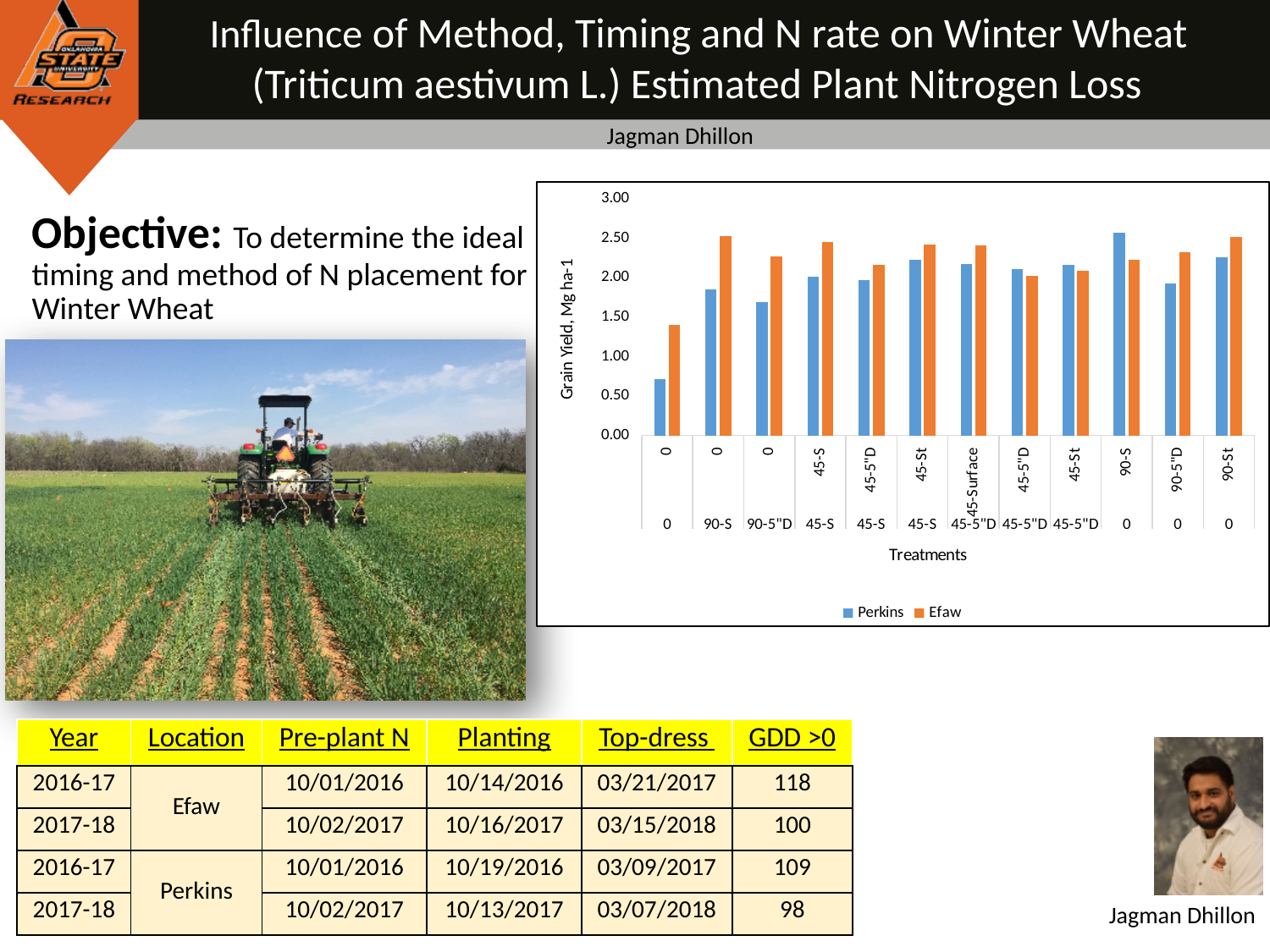
Is the Perkins value for the 90-5"D pre-plant treatment group greater or less than 2.00? less How many treatment groups are plotted along the x axis of the chart? 12 Is the Efaw value for the 90-S pre-plant treatment group greater or less than 2.00? greater What is the title of the vertical axis of the chart? Grain Yield, Mg ha-1 Which treatment group has the highest Perkins grain yield? 90-S top-dress (0 pre-plant) For the first treatment group (0 / 0), which series has the lower grain yield, Perkins or Efaw? Perkins Is the Perkins value for the first treatment group (0 / 0) greater or less than 1.00? less What kind of chart is shown on the slide? bar chart Which treatment group has the lowest Perkins grain yield? the first group (0 / 0) For the 90-S top-dress treatment group (0 pre-plant), which series has the higher grain yield, Perkins or Efaw? Perkins How many series does the chart legend list? 2 Which two series are listed in the chart legend? Perkins and Efaw